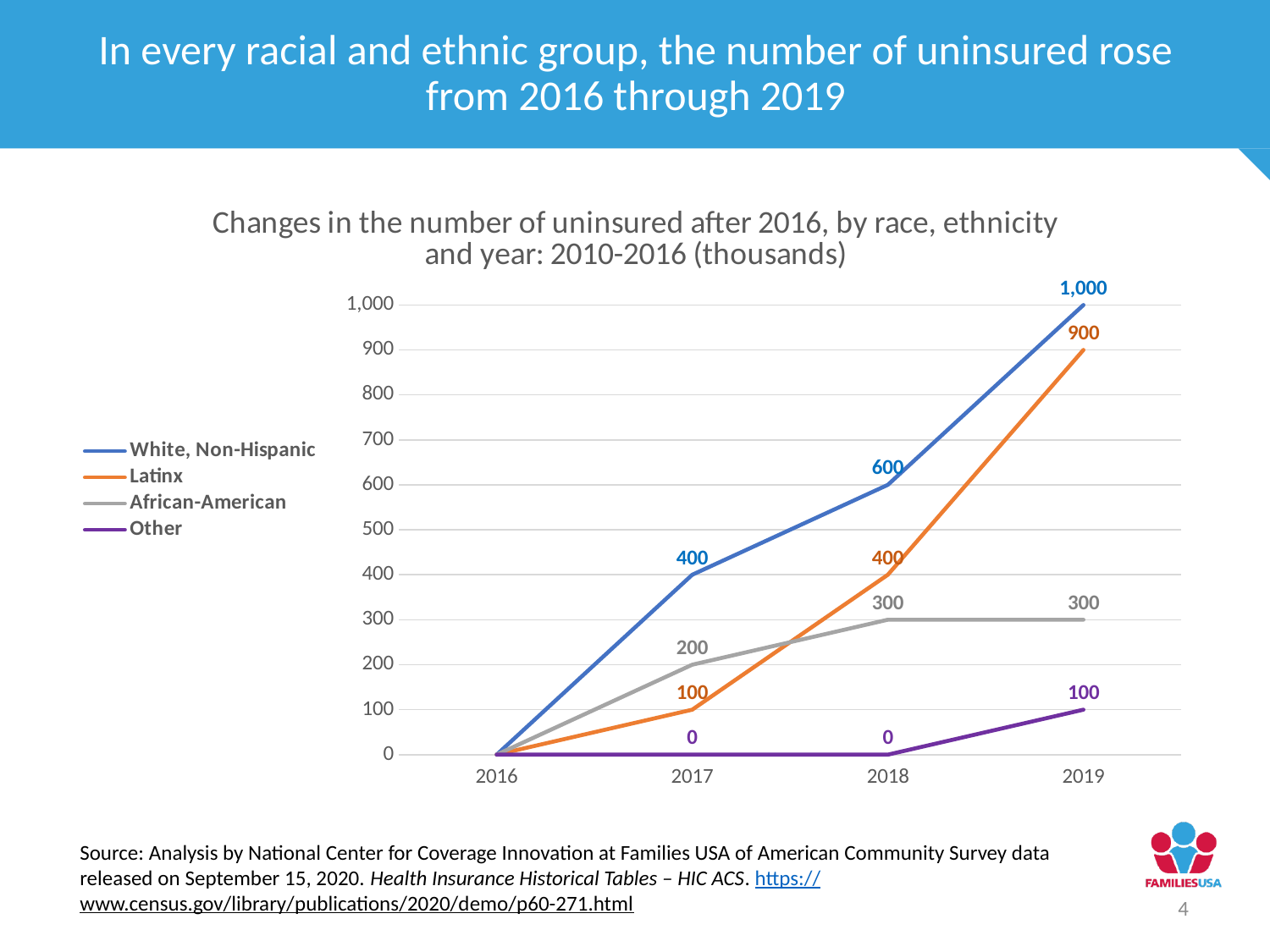
What is the value for White, Non-Hispanic in 2019? 1,000 How many series does the legend list? 4 What is the value for Other in 2019? 100 Which series has the highest value in 2019? White, Non-Hispanic Which series has the lowest value in 2018? Other Does the White, Non-Hispanic line rise or fall from 2016 to 2019? rise In 2017, which is larger: the value for Latinx or the value for African-American? African-American What is the difference between the White, Non-Hispanic and Latinx values in 2019? 100 What is the value for African-American in 2017? 200 What is the value for Latinx in 2018? 400 What type of chart is shown on the slide? line chart How many years are shown on the x axis? 4